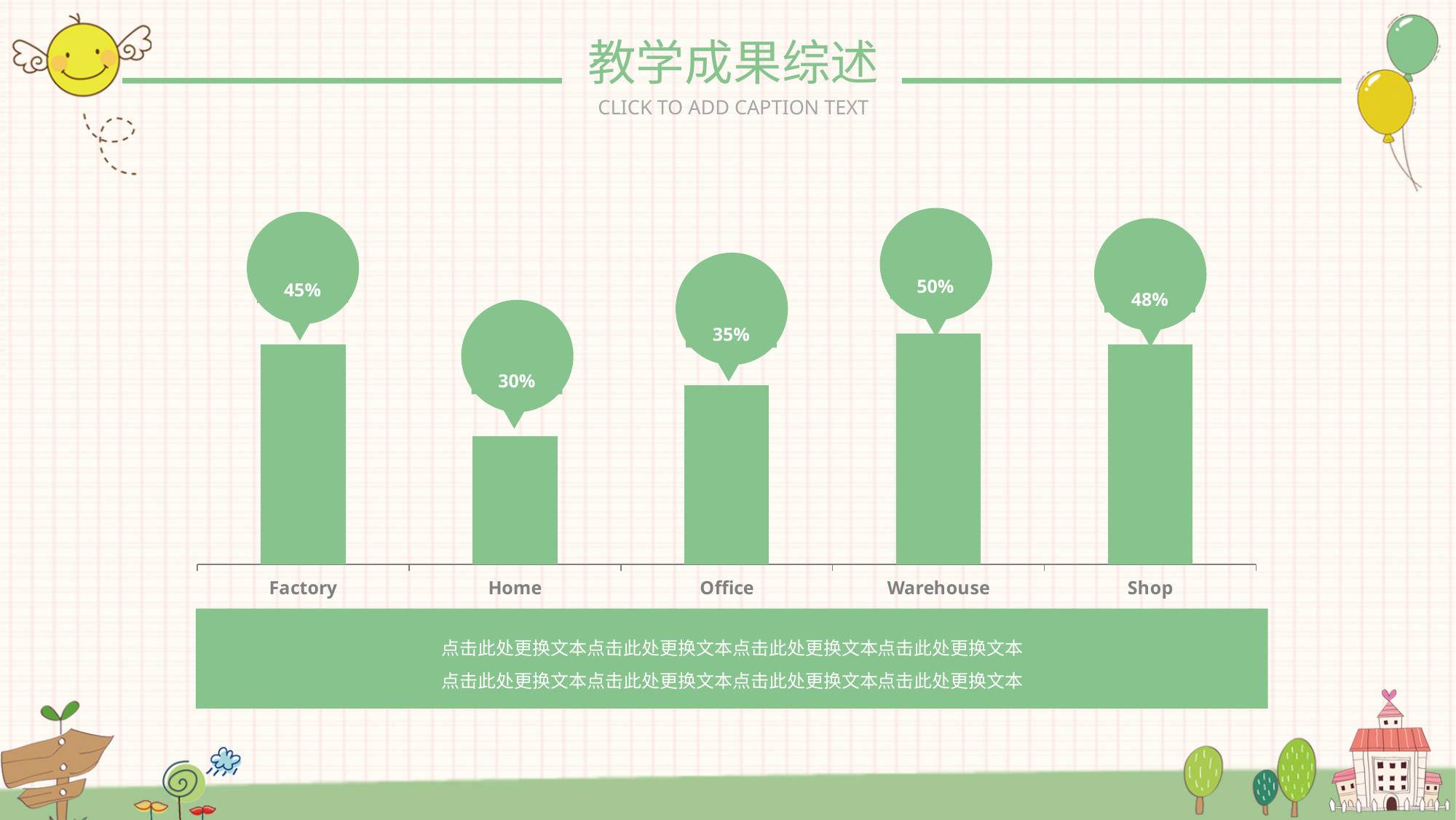
What is the value for Factory? 45% Which category has the lowest value? Home What is the value for Office? 35% What is the value for Warehouse? 50% What is the title of the slide containing the chart? 教学成果综述 What is the value for Home? 30% Which category has the highest value? Warehouse How many categories are shown in the chart? 5 What kind of chart is shown on the slide? Bar chart What is the difference between the values for Warehouse and Home? 20% Which is larger, the value for Factory or the value for Office? Factory What is the value for Shop? 48%